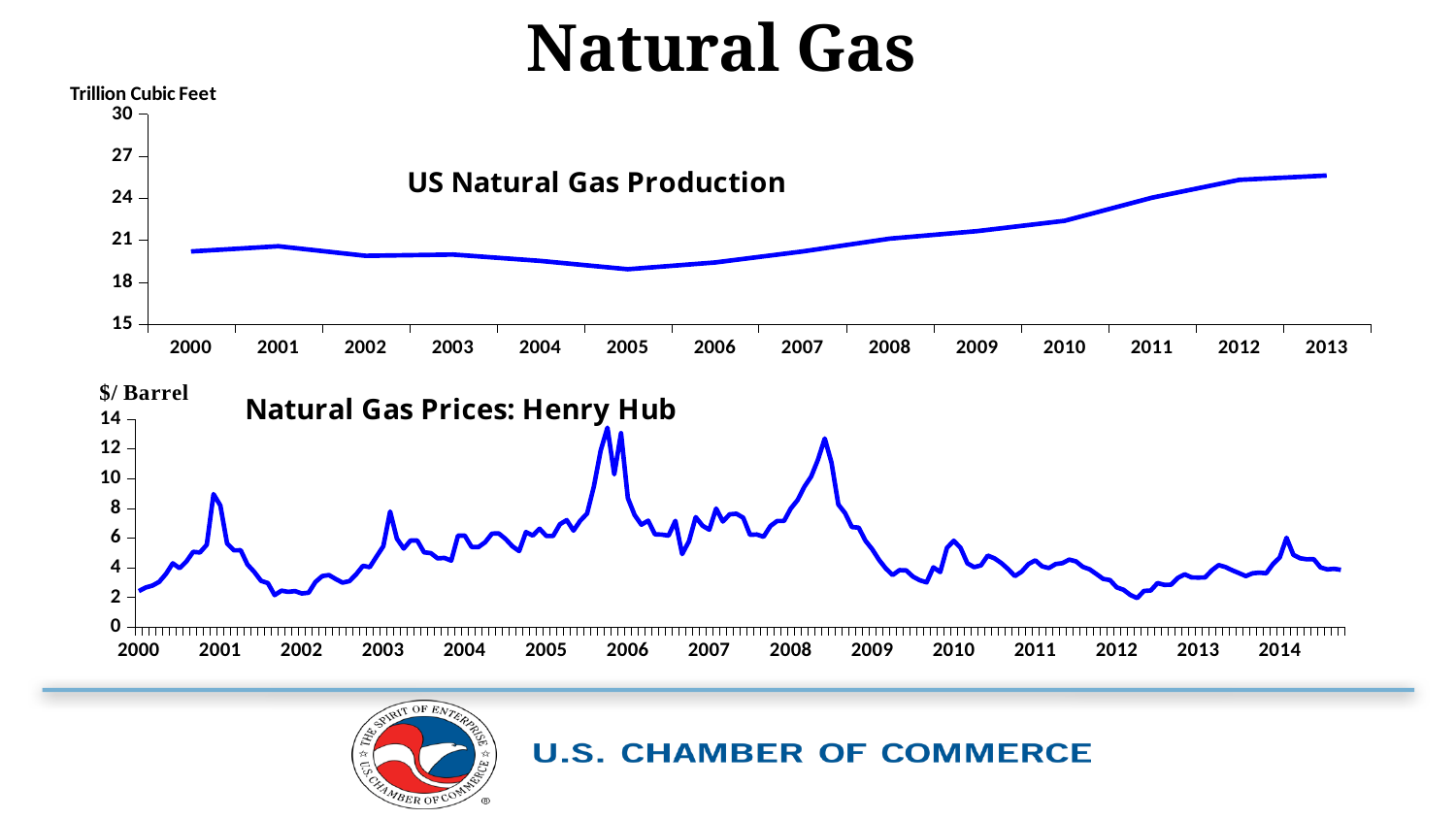
In the top chart, 'US Natural Gas Production', do values rise or fall from 2001 to 2005? fall What kind of chart is the bottom chart, 'Natural Gas Prices: Henry Hub'? line chart In the top chart, 'US Natural Gas Production', which year has the lowest production? 2005 In the top chart, 'US Natural Gas Production', how many years are labelled on the x axis? 14 In the bottom chart, 'Natural Gas Prices: Henry Hub', is the highest peak of the line greater or less than 12? greater In the top chart, 'US Natural Gas Production', is the value for 2005 greater or less than 21? less What kind of chart is the top chart, 'US Natural Gas Production'? line chart What unit is shown on the y axis of the top chart, 'US Natural Gas Production'? Trillion Cubic Feet In the top chart, 'US Natural Gas Production', is the value for 2013 greater or less than 24? greater In the bottom chart, 'Natural Gas Prices: Henry Hub', how many years are labelled on the x axis? 15 In the top chart, 'US Natural Gas Production', which year has the highest production? 2013 In the top chart, 'US Natural Gas Production', do values rise or fall from 2005 to 2013? rise